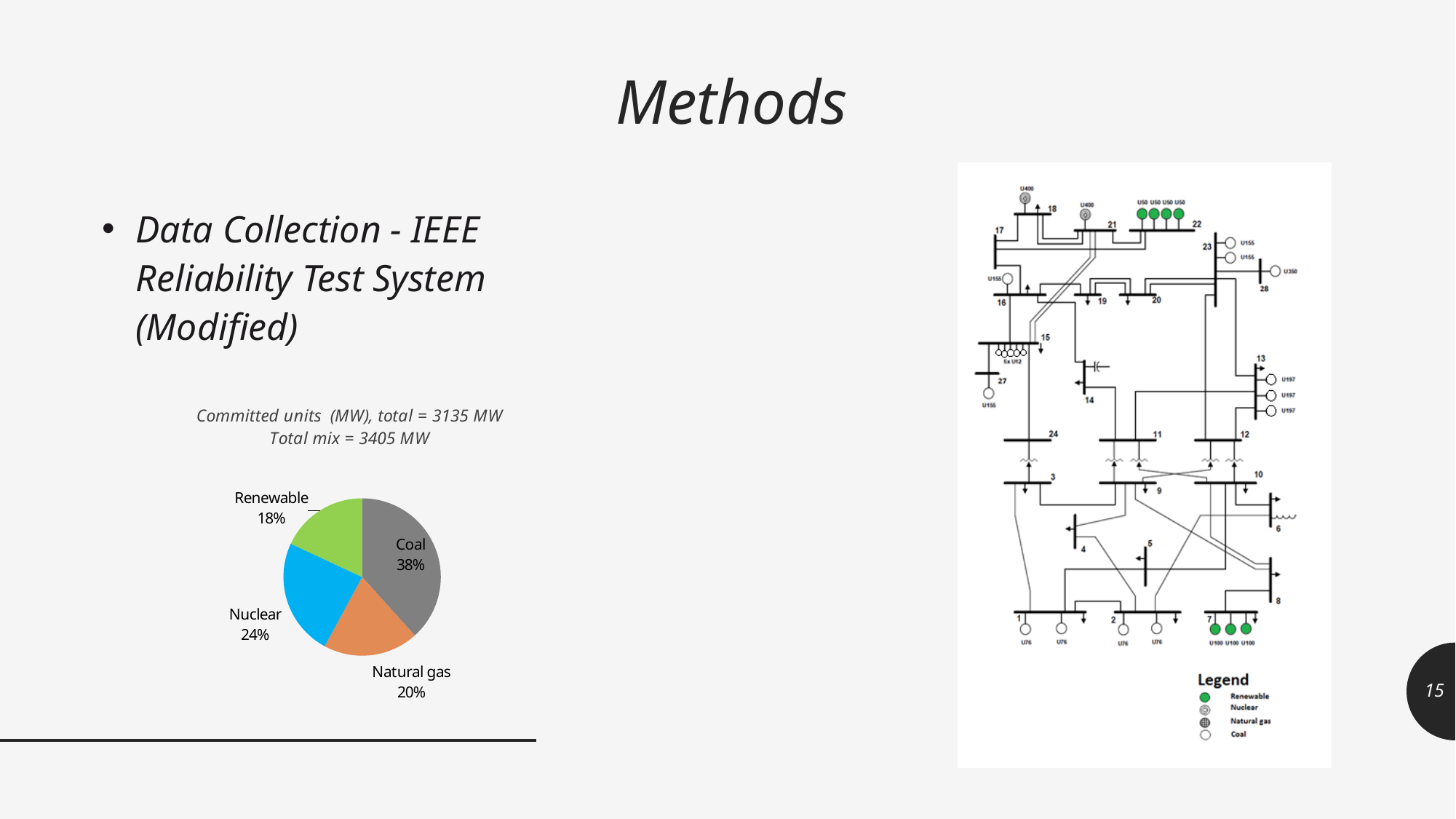
Which category has the largest slice in the pie chart? Coal Which is larger in the pie chart, Nuclear or Natural gas? Nuclear What share of the pie chart does Renewable represent? 18% How many categories are shown in the pie chart? 4 What is the title of the pie chart? Committed units (MW), total = 3135 MW Total mix = 3405 MW What colour is the Nuclear slice in the pie chart? blue What share of the pie chart does Natural gas represent? 20% Which category has the smallest slice in the pie chart? Renewable What type of chart is shown on the slide? pie chart What is the difference in percentage points between Coal and Renewable in the pie chart? 20 What share of the pie chart does Nuclear represent? 24% What share of the pie chart does Coal represent? 38%